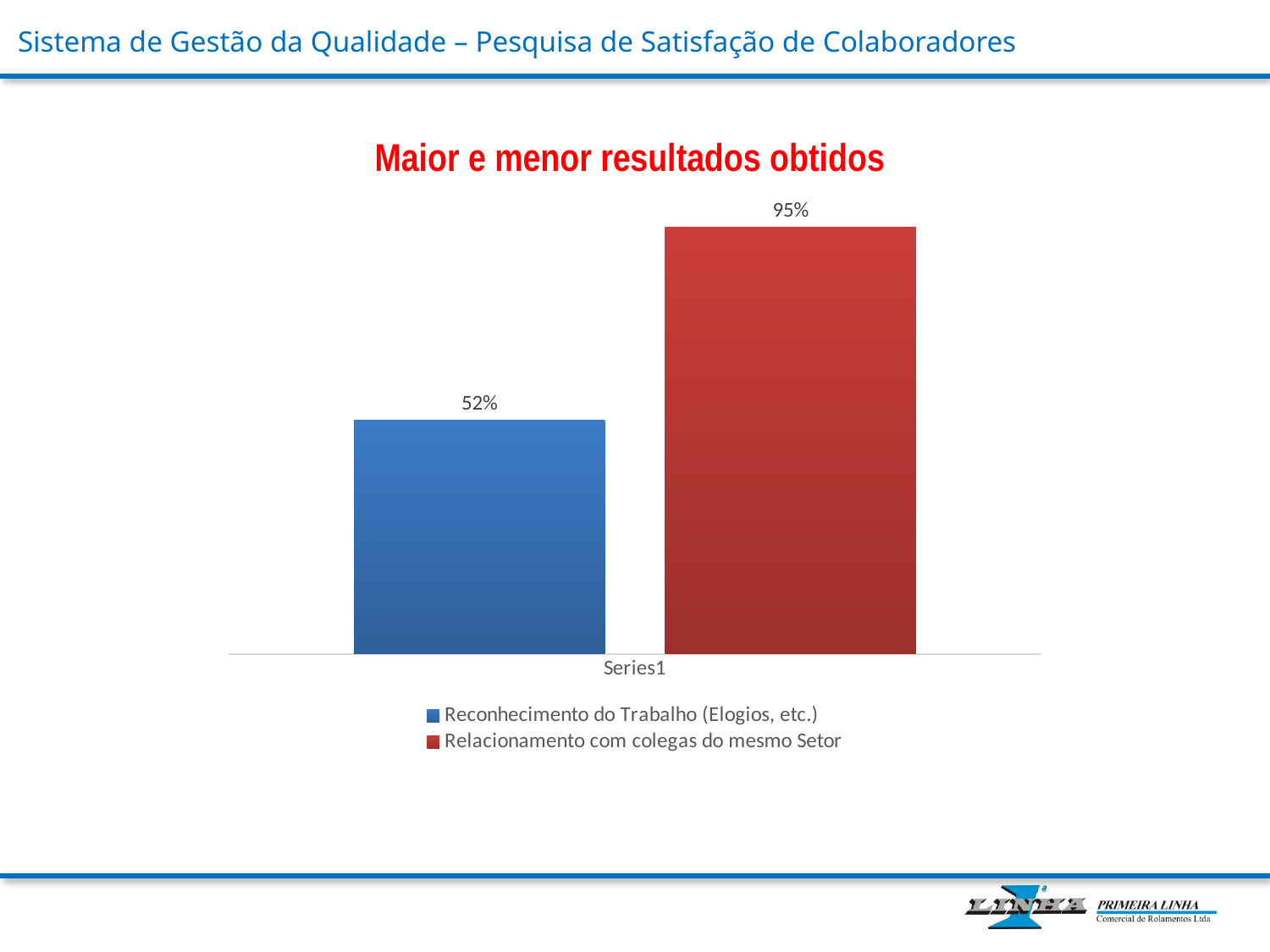
What is the value for Reconhecimento do Trabalho (Elogios, etc.)? 52% What is the title of the chart? Maior e menor resultados obtidos What is the difference between the values for Relacionamento com colegas do mesmo Setor and Reconhecimento do Trabalho (Elogios, etc.)? 43% Which series has the lowest value? Reconhecimento do Trabalho (Elogios, etc.) Which series has the highest value? Relacionamento com colegas do mesmo Setor Which is larger: the value for Reconhecimento do Trabalho (Elogios, etc.) or the value for Relacionamento com colegas do mesmo Setor? Relacionamento com colegas do mesmo Setor What colour is the bar for Relacionamento com colegas do mesmo Setor? Red How many series does the legend list? 2 How many bars are plotted in the chart? 2 What is the category label shown on the x axis? Series1 What kind of chart is shown on the slide? Bar chart What is the value for Relacionamento com colegas do mesmo Setor? 95%